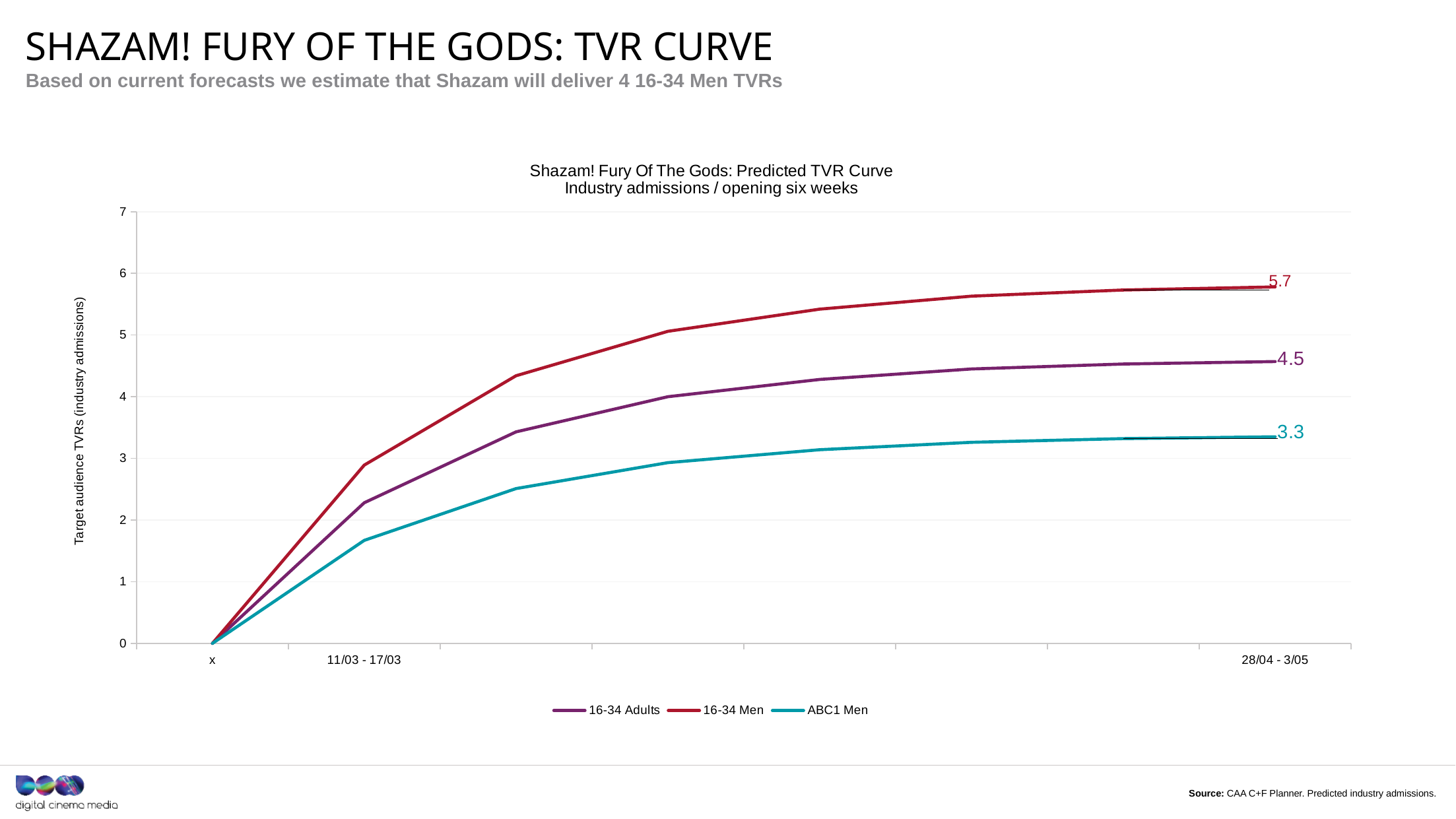
Which series reaches the highest final value? 16-34 Men Do the values rise or fall along the x axis? Rise What is the difference between the final values of 16-34 Men and ABC1 Men? 2.4 Is the value for ABC1 Men at 11/03 - 17/03 greater or less than 2? less Which series has the lowest final value? ABC1 Men Which has a higher final value, 16-34 Adults or ABC1 Men? 16-34 Adults What is the difference between the final values of 16-34 Men and 16-34 Adults? 1.2 How many series does the legend list? 3 What is the final value shown for the 16-34 Men series? 5.7 What is the final value shown for the ABC1 Men series? 3.3 What kind of chart is shown on the slide? Line chart What is the final value shown for the 16-34 Adults series? 4.5